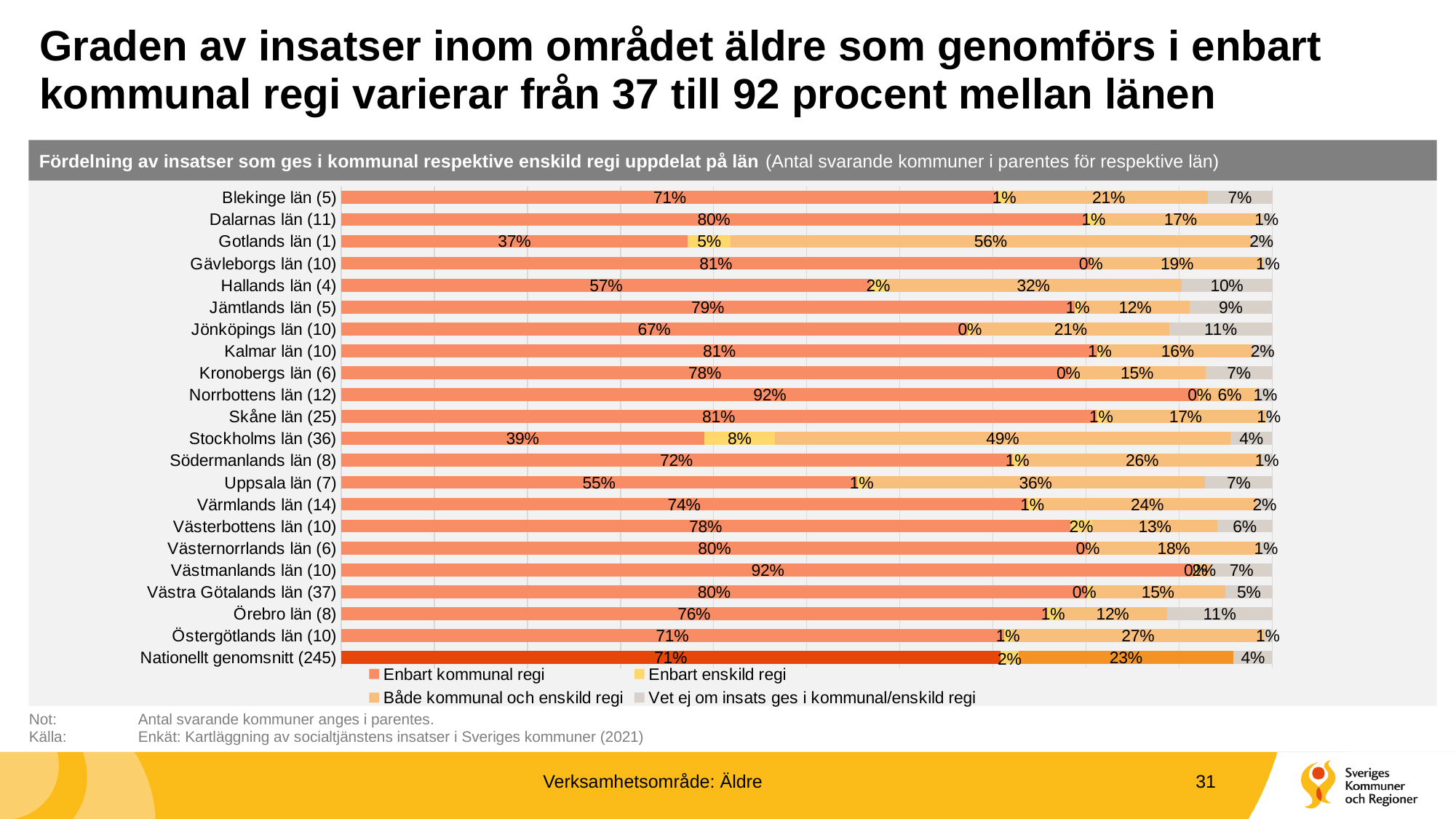
Which län has the lowest share of 'Enbart kommunal regi'? Gotlands län (1) How many series does the legend list? 4 What is the share of 'Vet ej om insats ges i kommunal/enskild regi' for Örebro län (8)? 11% What kind of chart is shown on the slide? Stacked bar chart What is the share of 'Både kommunal och enskild regi' for Stockholms län (36)? 49% What is the share of 'Enbart kommunal regi' for Nationellt genomsnitt (245)? 71% How many bars (län plus the national average) are plotted in the chart? 22 Which län has the highest share of 'Enbart enskild regi'? Stockholms län (36) Which has a larger share of 'Vet ej om insats ges i kommunal/enskild regi': Jönköpings län (10) or Blekinge län (5)? Jönköpings län (10) What is the share of 'Enbart kommunal regi' for Gotlands län (1)? 37% Which län has the highest share of 'Både kommunal och enskild regi'? Gotlands län (1) What is the difference in 'Enbart kommunal regi' share between Norrbottens län (12) and Hallands län (4)? 35 percentage points